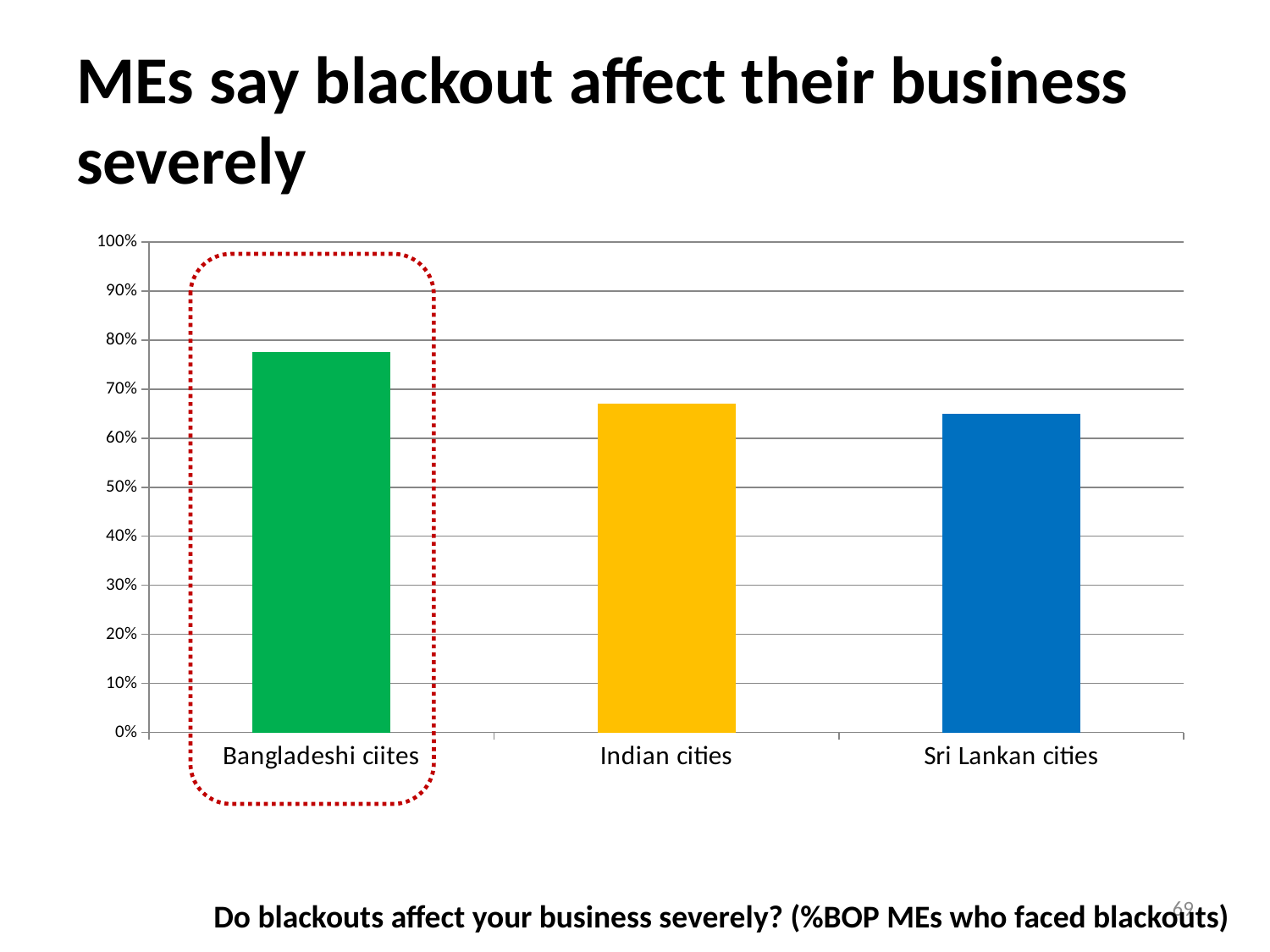
Is the value for Sri Lankan cities greater or less than 70%? less Is the value for Sri Lankan cities greater or less than 60%? greater How many categories are plotted on the chart? 3 Which is larger, the value for Bangladeshi ciites or the value for Sri Lankan cities? Bangladeshi ciites Is the value for Indian cities greater or less than 70%? less What kind of chart is shown on the slide? bar chart Do the values rise or fall from left to right along the x axis? fall Which category's bar is enclosed by the red dotted outline? Bangladeshi ciites Which category has the highest value? Bangladeshi ciites